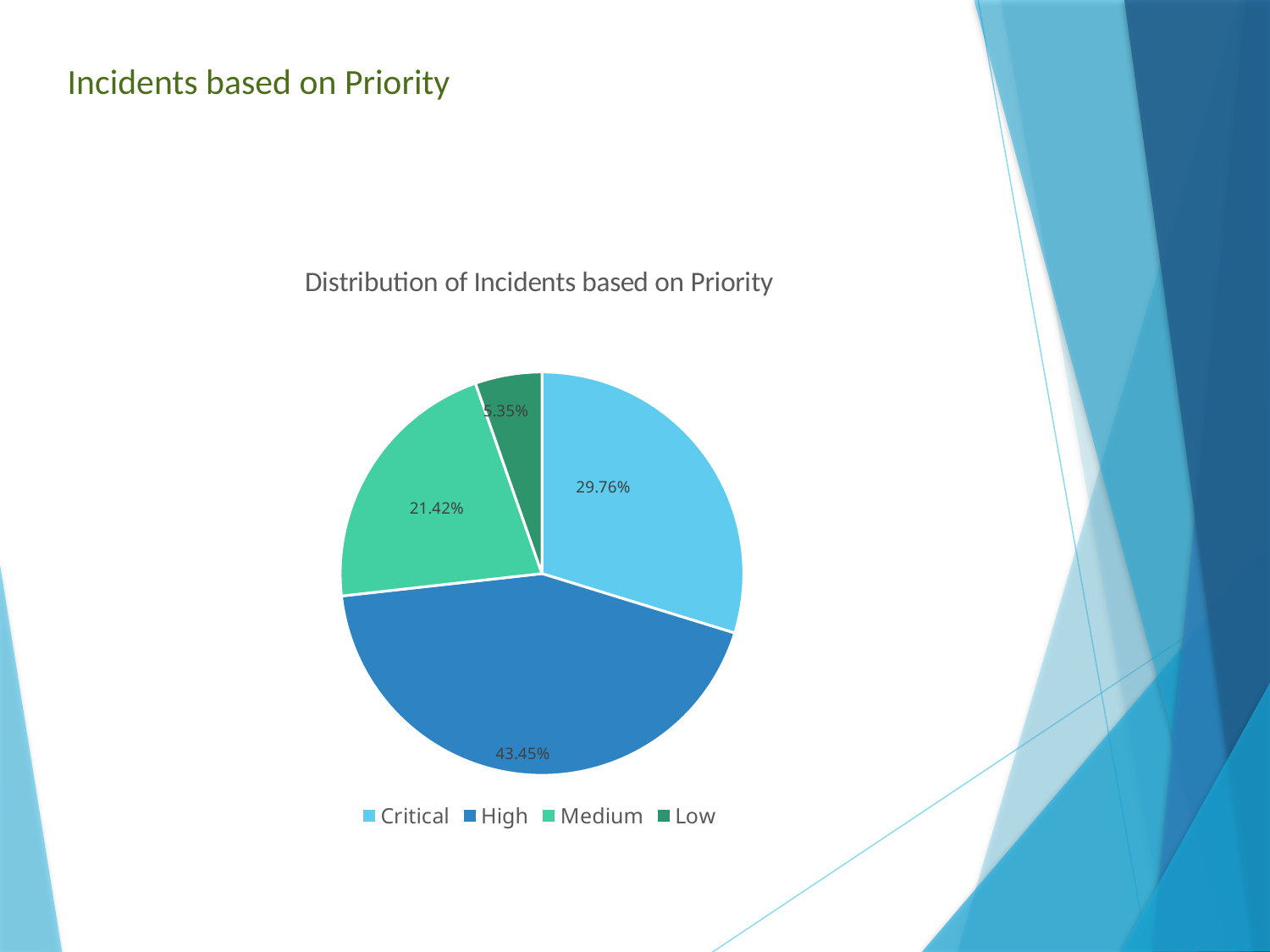
What percentage of incidents are Critical priority? 29.76% What is the difference in percentage points between the High and Critical shares? 13.69 How many priority categories are shown in the pie chart? 4 What percentage of incidents are Low priority? 5.35% Which priority category has the largest share of incidents? High What percentage of incidents are High priority? 43.45% What type of chart is shown on the slide? Pie chart What is the title of the chart? Distribution of Incidents based on Priority Which has a larger share of incidents, Critical or Medium? Critical Which category is shown in the darkest green colour in the legend? Low What percentage of incidents are Medium priority? 21.42% Which priority category has the smallest share of incidents? Low